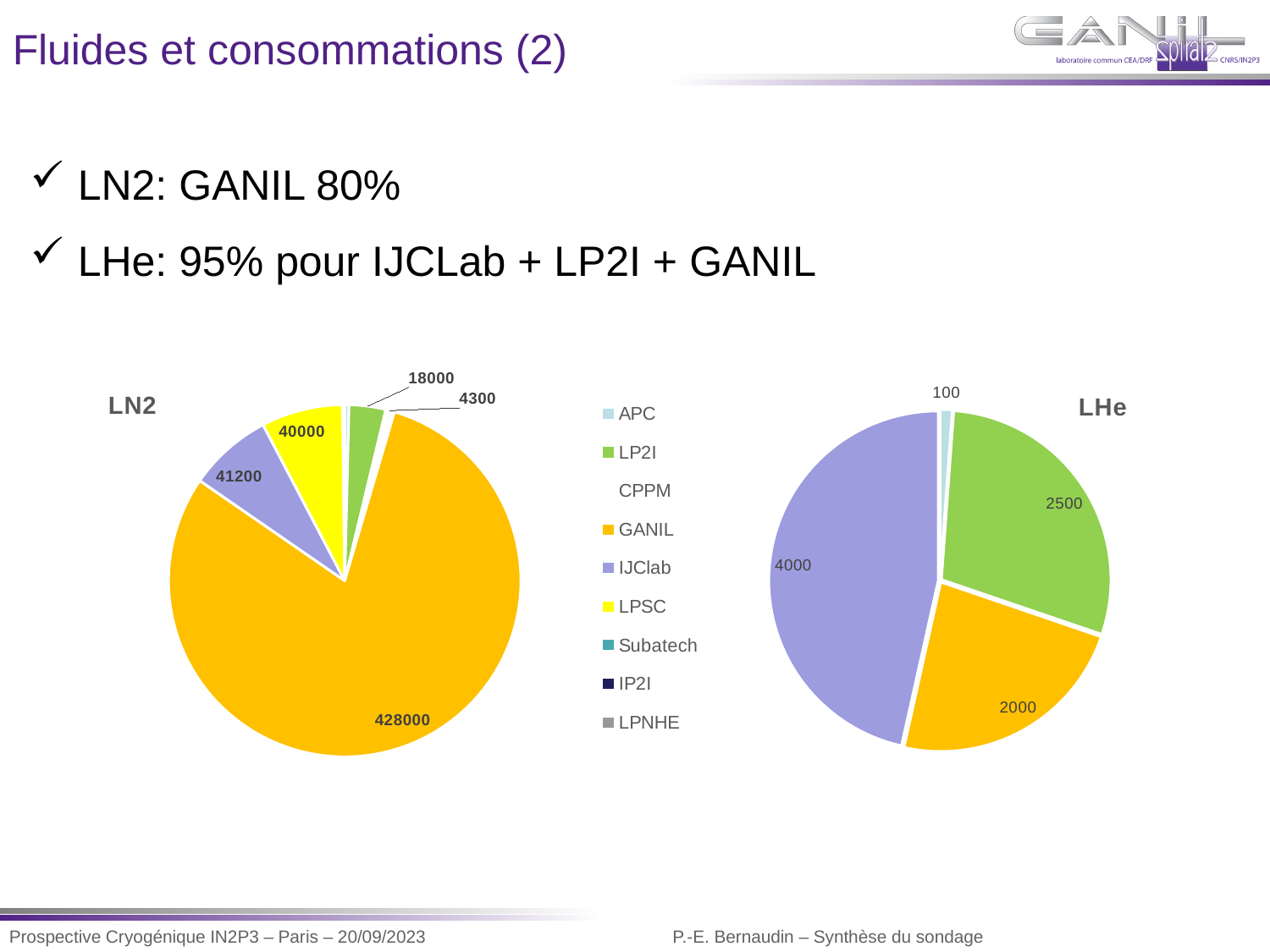
In the LN2 pie chart, what is the value for IJClab? 41200 What type of chart is used for the LN2 and LHe data on this slide? Pie chart In the LHe pie chart, what is the value for IJClab? 4000 In the LHe pie chart, what is the difference between the IJClab value and the LP2I value? 1500 In the LHe pie chart, which laboratory has the largest slice? IJClab In the LHe pie chart, which is larger, the LP2I slice or the GANIL slice? LP2I In the LHe pie chart, what is the value for GANIL? 2000 In the LN2 pie chart, which laboratory has the largest slice? GANIL In the LN2 pie chart, what is the value for GANIL? 428000 In the LHe pie chart, what is the value for LP2I? 2500 In the LN2 pie chart, what is the value for LPSC? 40000 In the LN2 pie chart, what is the value for LP2I? 18000